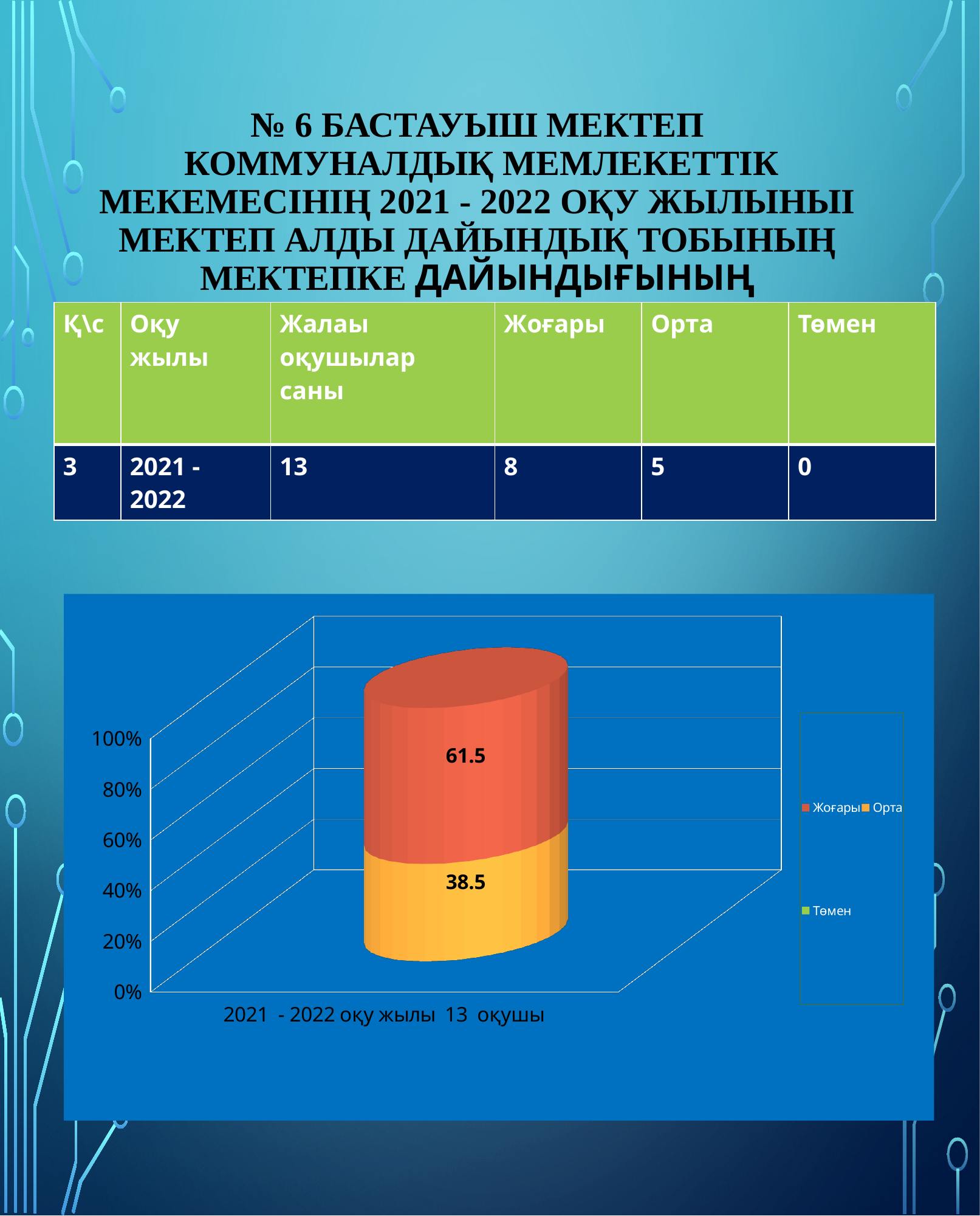
Which series has the largest labelled value in the chart? Жоғары What kind of chart is shown on the slide? Stacked bar chart What is the category label on the x axis of the chart? 2021 - 2022 оқу жылы 13 оқушы What value is shown for the Орта series in the chart? 38.5 Which series names appear in the chart legend? Жоғары, Орта, Төмен How many categories are shown on the x axis of the chart? 1 What value is shown for the Жоғары series in the chart? 61.5 What is the sum of the two labelled segments (Жоғары and Орта) in the stacked bar? 100 How many series does the chart legend list? 3 What is the difference between the Жоғары value and the Орта value in the chart? 23 Which series has the larger labelled value in the chart, Жоғары or Орта? Жоғары